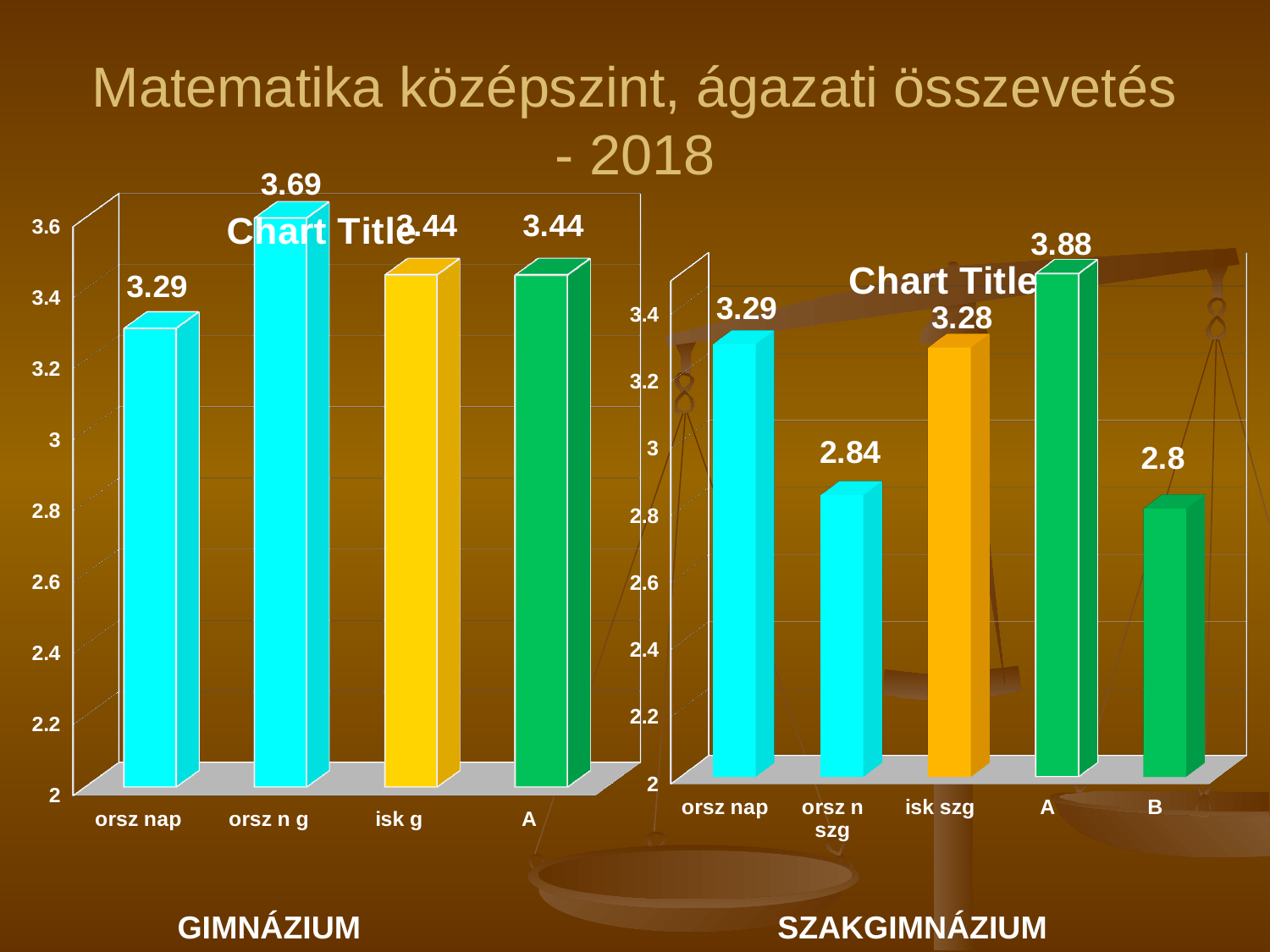
In the right chart (SZAKGIMNÁZIUM), which category has the lowest value? B In the left chart (GIMNÁZIUM), what is the value for orsz n g? 3.69 In the right chart (SZAKGIMNÁZIUM), what is the difference between the values for A and B? 1.08 In the left chart (GIMNÁZIUM), what is the difference between the values for orsz n g and orsz nap? 0.4 How many categories are shown in the right chart (SZAKGIMNÁZIUM)? 5 In the left chart (GIMNÁZIUM), which category has the highest value? orsz n g How many categories are shown in the left chart (GIMNÁZIUM)? 4 In the right chart (SZAKGIMNÁZIUM), which is larger, the value for orsz nap or the value for isk szg? orsz nap In the right chart (SZAKGIMNÁZIUM), what is the value for orsz n szg? 2.84 In the right chart (SZAKGIMNÁZIUM), what is the value for A? 3.88 In the left chart (GIMNÁZIUM), what is the value for orsz nap? 3.29 What kind of chart is the left chart (GIMNÁZIUM)? bar chart